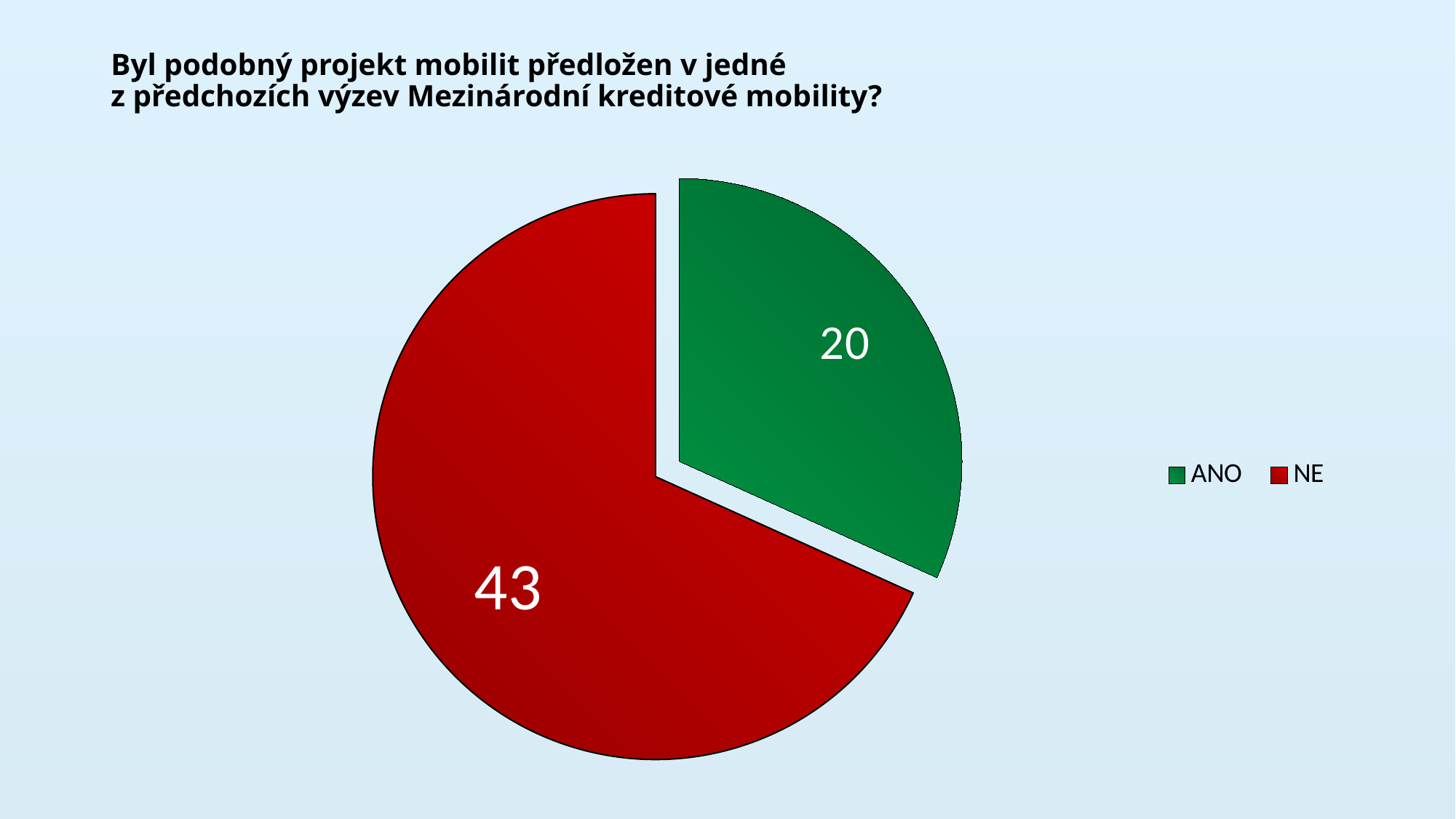
How many entries does the legend list? 2 What kind of chart is shown on the slide? Pie chart What is the total of the two slice values? 63 Which is larger, the value for ANO or the value for NE? NE What value is shown for the NE slice? 43 What is the difference between the NE value and the ANO value? 23 What colour is the NE slice? Red How many slices does the pie chart have? 2 What colour is the ANO slice? Green Which category has the largest slice of the pie? NE What value is shown for the ANO slice? 20 Which category has the smallest slice of the pie? ANO